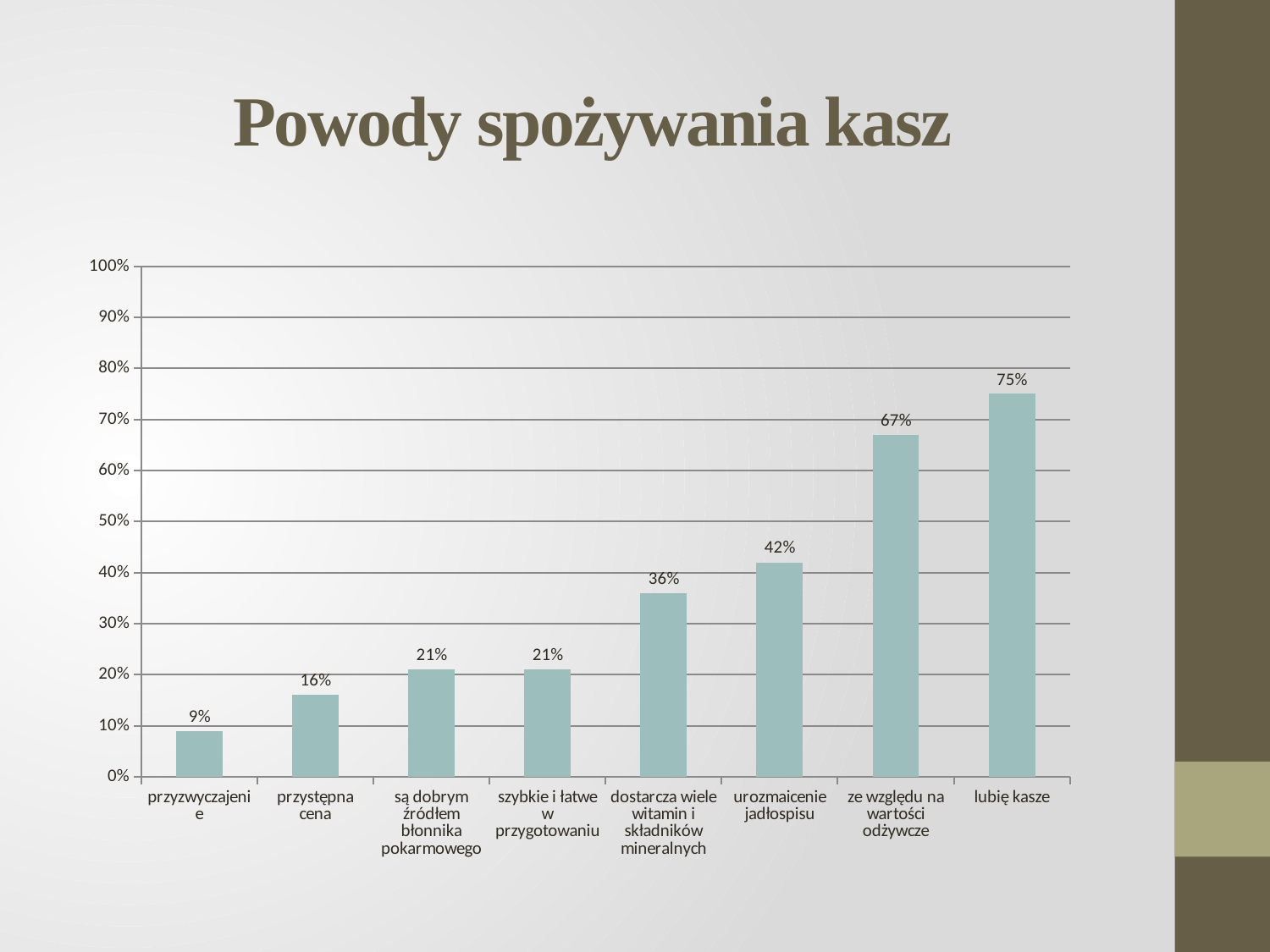
What is the difference between the values for "lubię kasze" and "przyzwyczajenie"? 66% What is the value for "przystępna cena"? 16% Which category has the highest value? lubię kasze Which is larger, the value for "dostarcza wiele witamin i składników mineralnych" or the value for "urozmaicenie jadłospisu"? urozmaicenie jadłospisu What is the value for "ze względu na wartości odżywcze"? 67% How many categories are shown on the chart? 8 Do the values rise or fall from left to right along the x axis? rise Which category has the lowest value? przyzwyczajenie What is the value for "lubię kasze"? 75% Is the value for "ze względu na wartości odżywcze" greater or less than 60%? greater What is the value for "urozmaicenie jadłospisu"? 42% What kind of chart is shown on the slide? bar chart